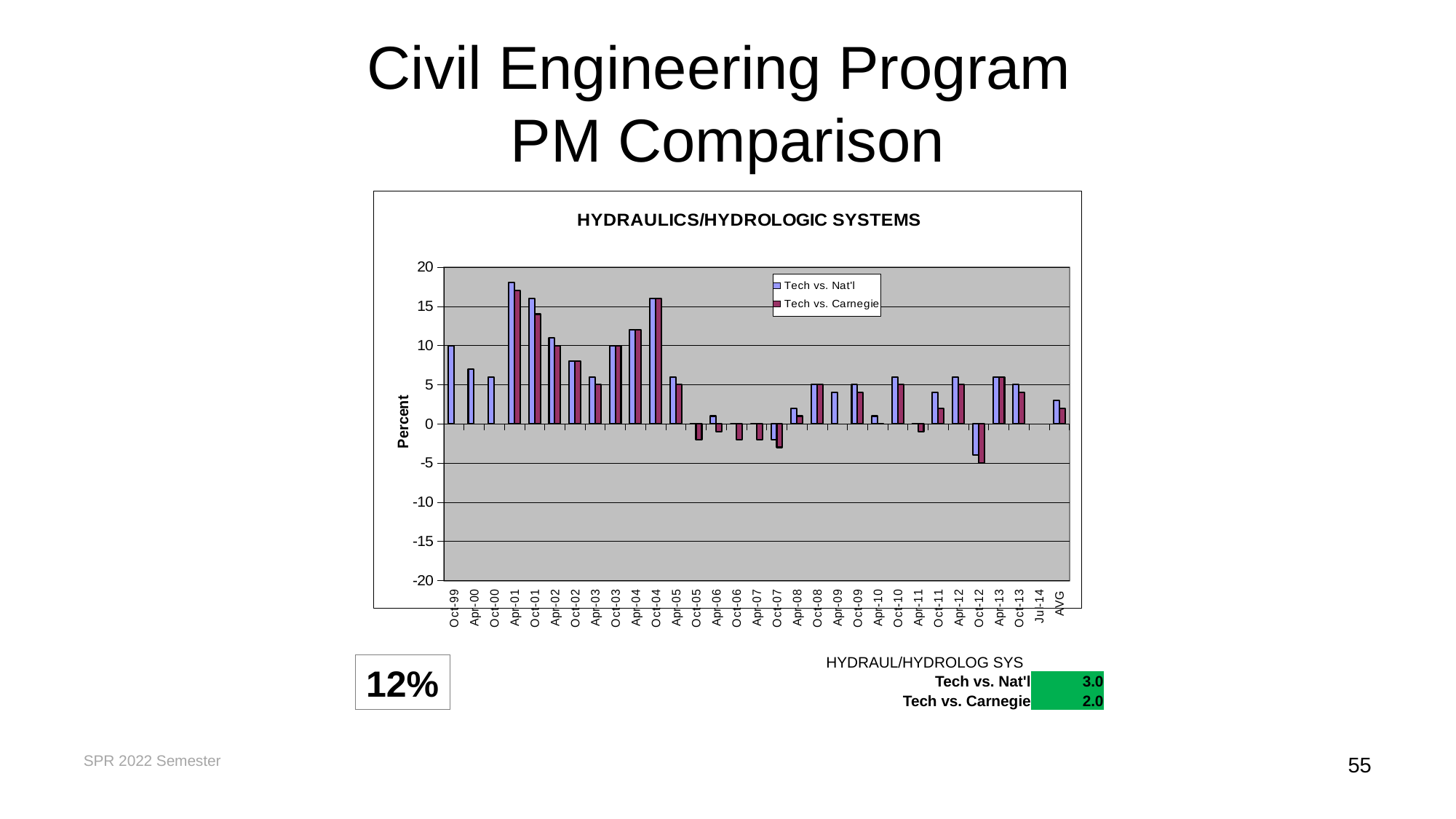
What is the title of the chart? HYDRAULICS/HYDROLOGIC SYSTEMS What kind of chart is shown on the slide? bar chart How many series does the chart's legend list? 2 Which period has the lowest Tech vs. Carnegie value? Oct-12 Which is larger, the Tech vs. Nat'l value for Oct-04 or for Oct-05? Oct-04 What is the label on the chart's vertical axis? Percent Which period has the highest Tech vs. Nat'l value? Apr-01 Is the Tech vs. Nat'l value for Apr-01 greater or less than 15? greater According to the table below the chart, what is the AVG value for Tech vs. Carnegie? 2.0 According to the table below the chart, what is the AVG value for Tech vs. Nat'l? 3.0 Is the Tech vs. Carnegie value for Oct-12 greater or less than 0? less What is the difference between the AVG values for Tech vs. Nat'l and Tech vs. Carnegie shown in the table? 1.0